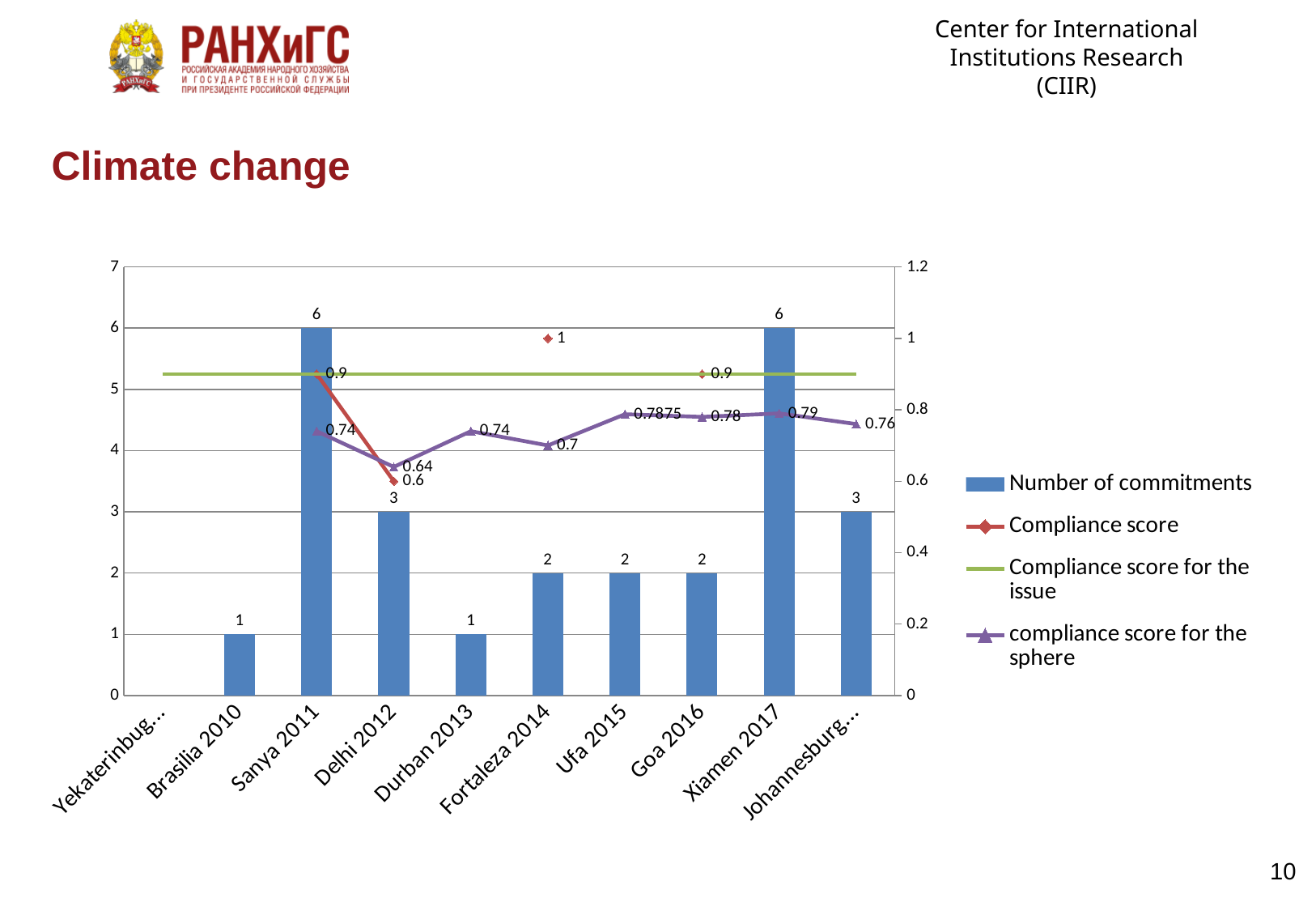
What is the difference between the Number of commitments for Sanya 2011 and Delhi 2012? 3 What is the Number of commitments for Sanya 2011? 6 What is the Number of commitments for Delhi 2012? 3 Is the Compliance score for the issue line greater or less than 0.8? greater What is the highest value shown for Number of commitments? 6 What is the compliance score for the sphere at Delhi 2012? 0.64 Does the compliance score for the sphere rise or fall from Sanya 2011 to Delhi 2012? Fall What kind of chart is shown on the slide? A combined bar and line chart Which has the higher compliance score for the sphere, Fortaleza 2014 or Ufa 2015? Ufa 2015 What is the Compliance score at Fortaleza 2014? 1 How many series does the legend list? 4 How many summit categories are shown on the x axis? 10